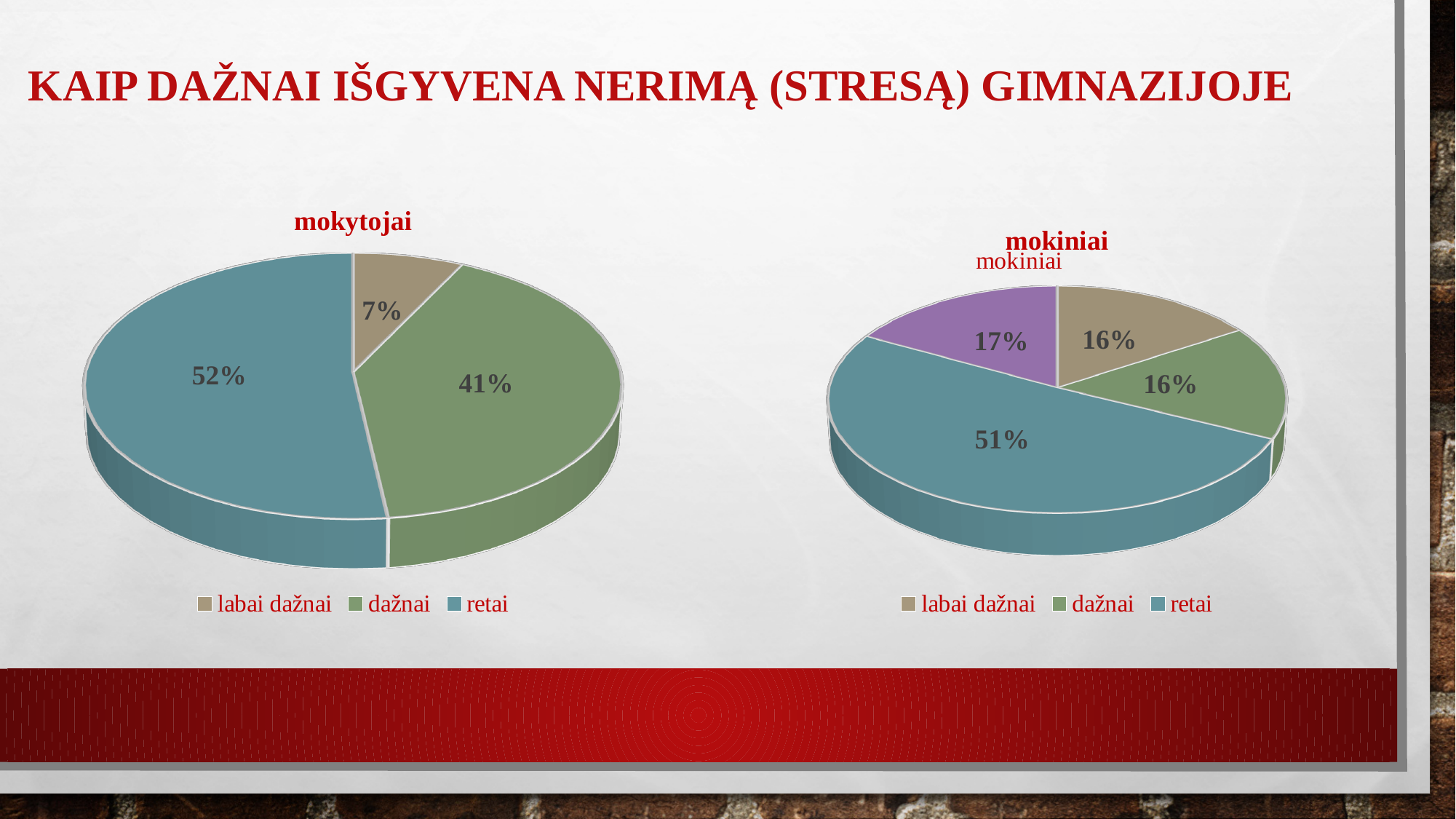
In the mokiniai pie chart, what percentage is shown for labai dažnai? 16% In the mokytojai pie chart, which category has the largest share? retai In the mokytojai pie chart, what percentage is shown for retai? 52% Which is larger: the retai share in the mokytojai chart or the retai share in the mokiniai chart? mokytojai In the mokytojai pie chart, what percentage is shown for dažnai? 41% In the mokytojai pie chart, which category has the smallest share? labai dažnai How many slices does the mokiniai pie chart have? 4 In the mokytojai pie chart, what percentage is shown for labai dažnai? 7% In the mokiniai pie chart, what percentage is shown for retai? 51% What type of chart is used for the mokytojai data? pie chart How many entries does the legend of the mokytojai chart list? 3 In the mokytojai pie chart, what is the difference between the retai and dažnai shares? 11%